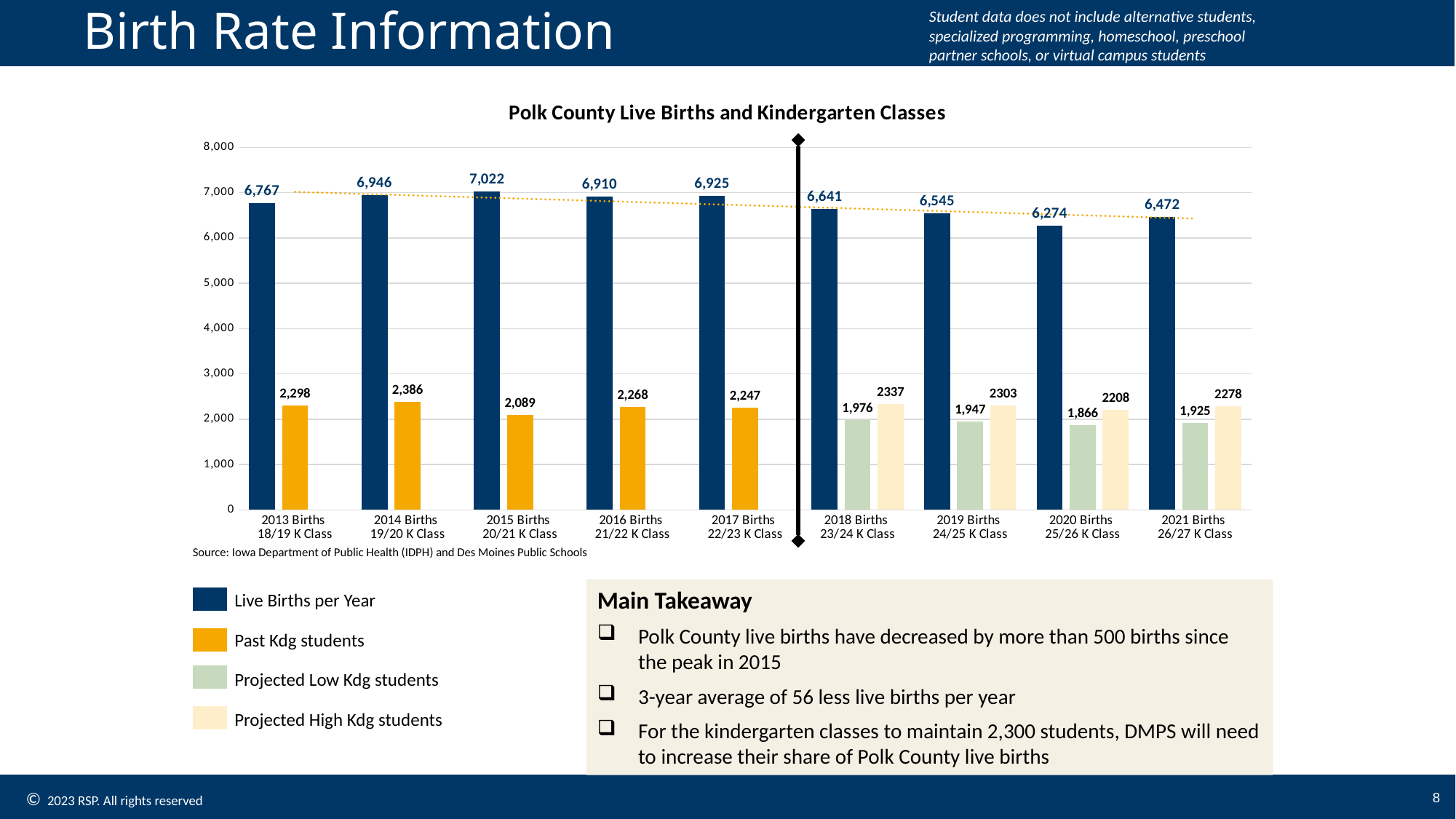
What is the value of Past Kdg students for 2014 Births 19/20 K Class? 2,386 What kind of chart is shown on the slide? Bar chart For 2018 Births 23/24 K Class, what is the difference between Projected High Kdg students and Projected Low Kdg students? 361 What is the difference between the highest Live Births per Year (2015) and the lowest (2020)? 748 Which category has the lowest Live Births per Year? 2020 Births 25/26 K Class Which category has the highest Live Births per Year? 2015 Births 20/21 K Class Which has more Live Births per Year: 2016 Births 21/22 K Class or 2017 Births 22/23 K Class? 2017 Births 22/23 K Class How many categories are shown on the x axis? 9 Which category has the lowest Past Kdg students value? 2015 Births 20/21 K Class How many series does the legend list? 4 What is the value of Live Births per Year for 2015 Births 20/21 K Class? 7,022 What is the value of Projected High Kdg students for 2021 Births 26/27 K Class? 2278